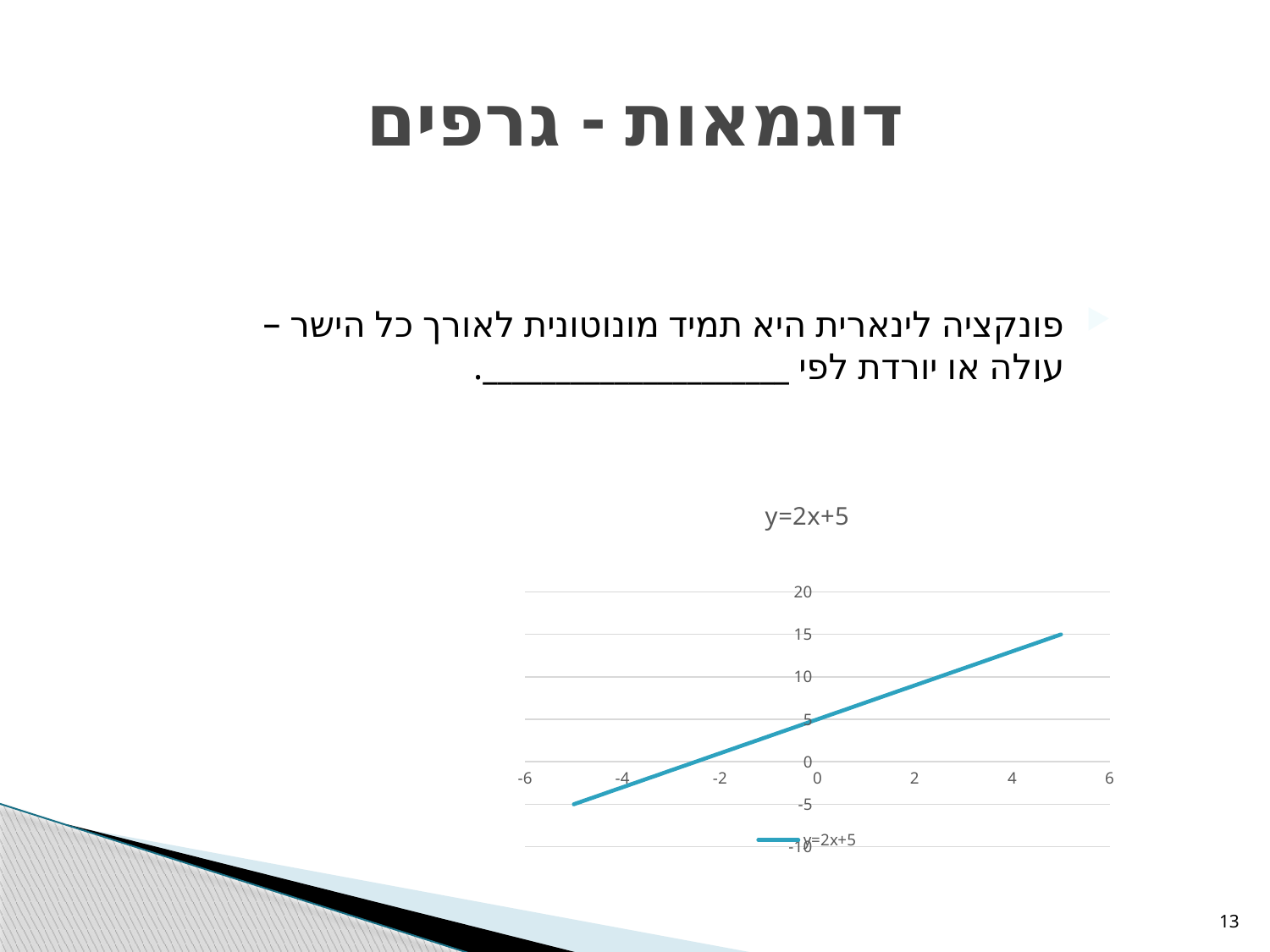
Does the line rise or fall as x increases from left to right? rises What kind of chart is shown on the slide? line chart Which is larger: the value of the line at x = 4 or at x = -4? x = 4 What is the highest value shown on the y axis? 20 Is the value of the line at x = -4 greater or less than 0? less What is the title of the chart? y=2x+5 How many series does the chart's legend list? 1 Is the value of the line at x = 4 greater or less than 10? greater What is the value of y where the line crosses x = 0? 5 Is the value of the line at x = 2 greater or less than 5? greater